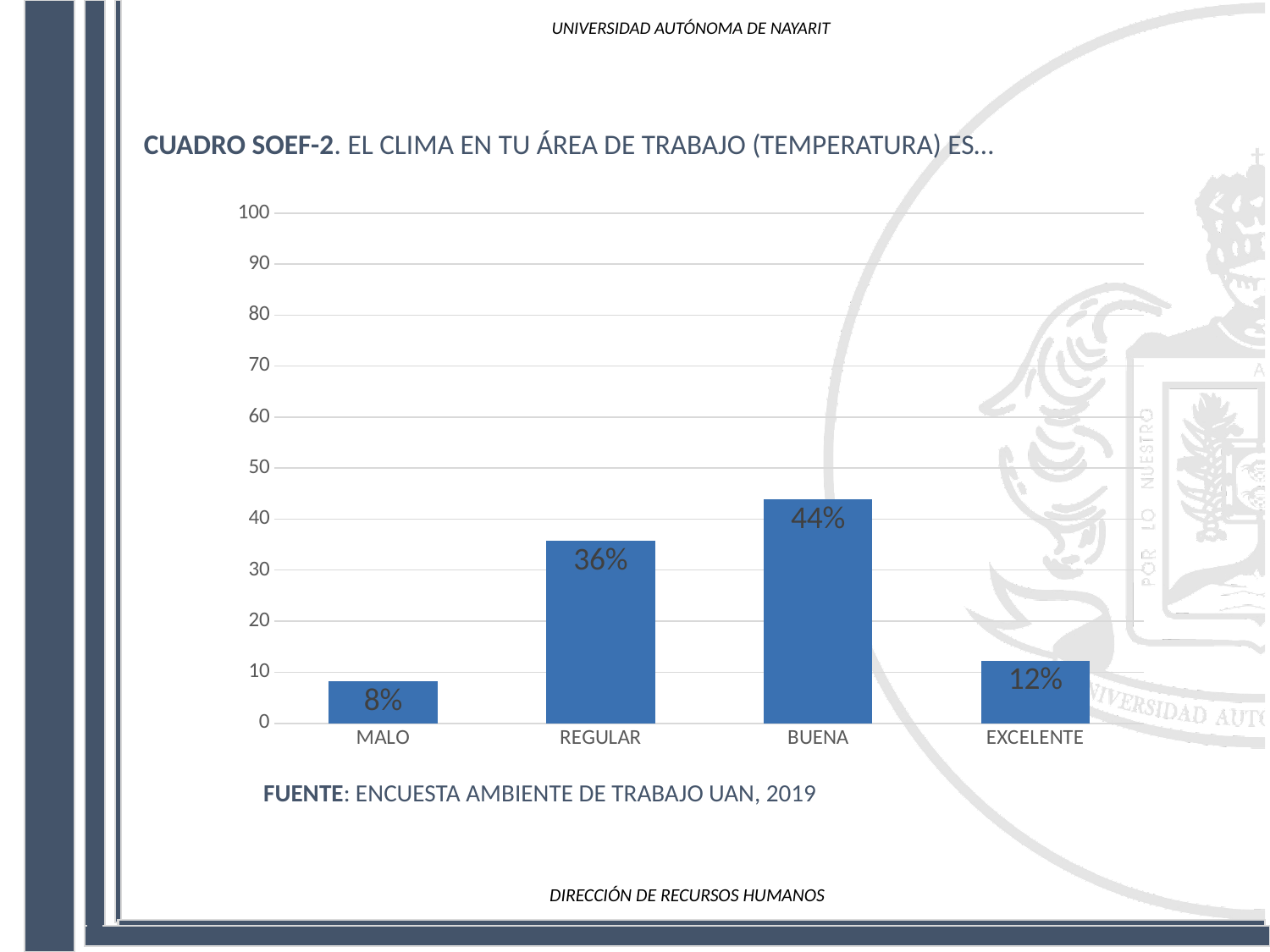
What is the value for BUENA? 44% Is the value for REGULAR greater or less than 30? greater What is the difference between the values for BUENA and REGULAR? 8% What is the value for MALO? 8% What is the difference between the values for EXCELENTE and MALO? 4% Which category has the lowest value? MALO What is the value for EXCELENTE? 12% How many categories are shown on the x axis? 4 What kind of chart is shown on the slide? Bar chart Which is larger, the value for REGULAR or the value for EXCELENTE? REGULAR What is the source cited below the chart? ENCUESTA AMBIENTE DE TRABAJO UAN, 2019 Which category has the highest value? BUENA